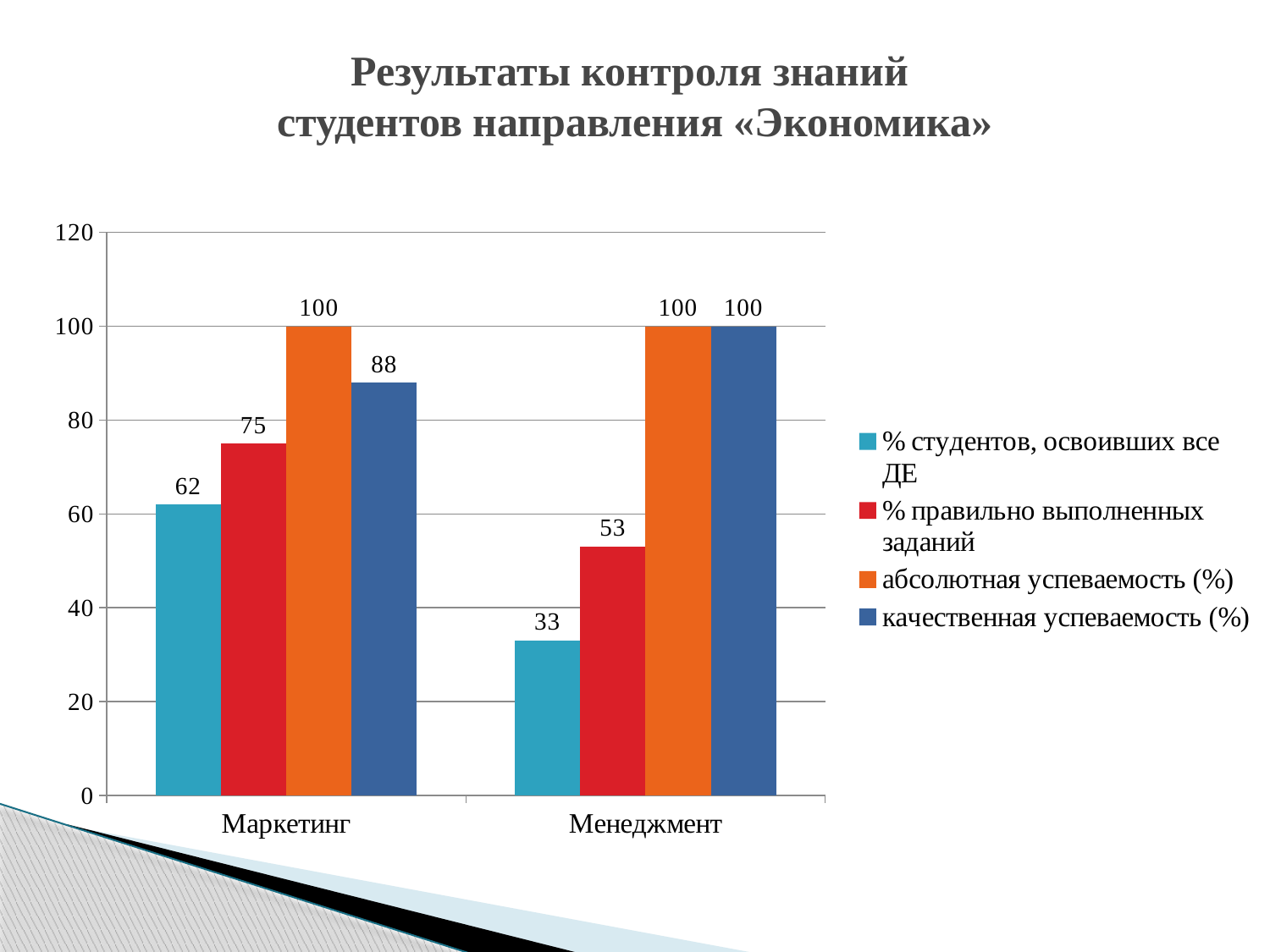
Which category has the higher value for «% правильно выполненных заданий»? Маркетинг How many categories are shown on the x axis? 2 What is the value of «качественная успеваемость (%)» for Маркетинг? 88 What kind of chart is shown on the slide? Bar chart What is the value of «% студентов, освоивших все ДЕ» for Маркетинг? 62 How many series does the legend list? 4 Which category has the lowest value for «% студентов, освоивших все ДЕ»? Менеджмент What is the value of «% правильно выполненных заданий» for Менеджмент? 53 Which series is shown in orange? абсолютная успеваемость (%) What is the difference between the «% студентов, освоивших все ДЕ» values for Маркетинг and Менеджмент? 29 What is the value of «абсолютная успеваемость (%)» for Менеджмент? 100 What is the difference between «качественная успеваемость (%)» for Менеджмент and for Маркетинг? 12